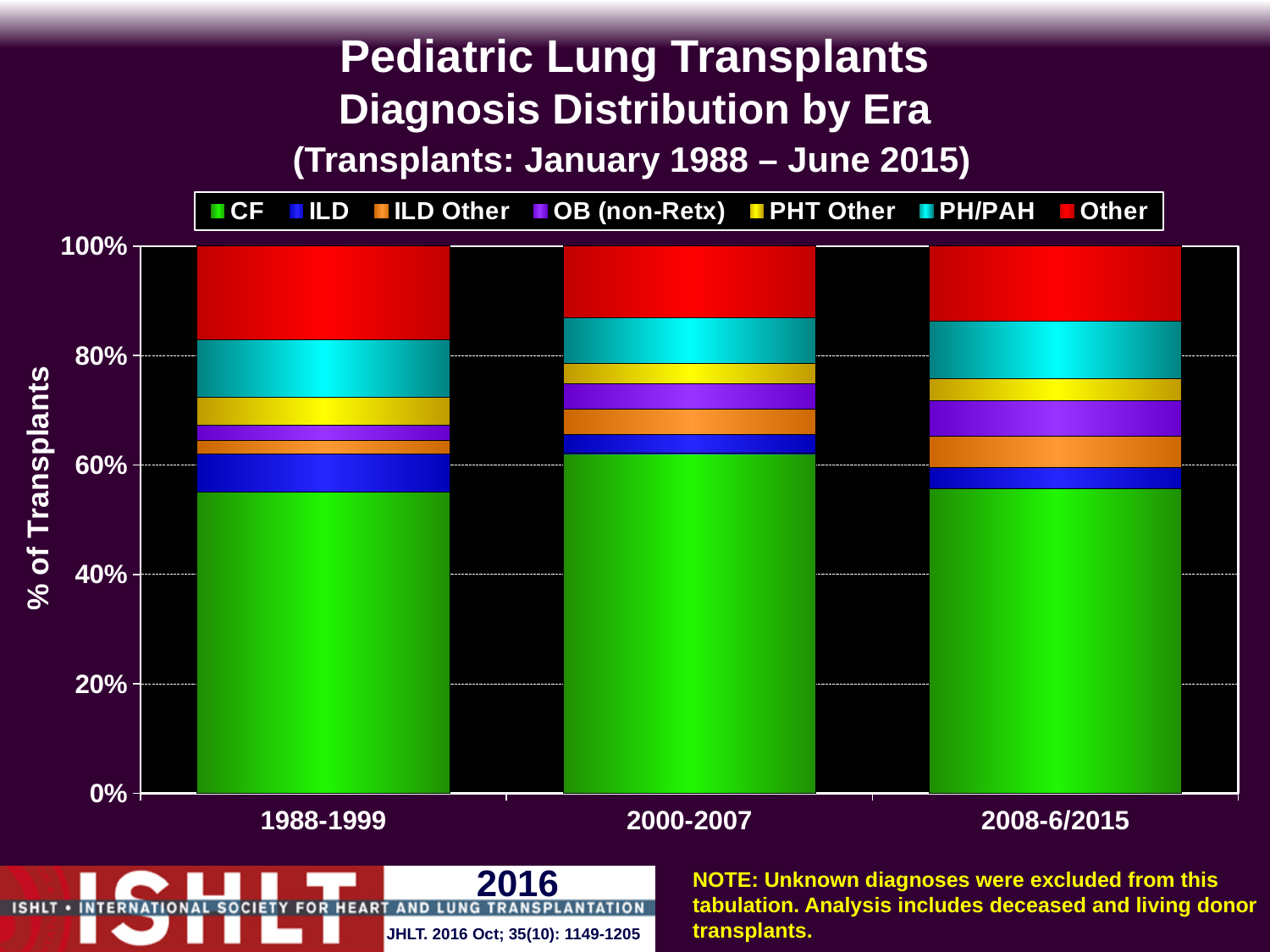
Is the CF share of transplants in the 1988-1999 era greater or less than 60%? less Which diagnosis is listed first in the legend? CF How many eras (categories) are shown on the x axis? 3 How many diagnosis series does the legend list? 7 Which era has a larger CF share of transplants, 1988-1999 or 2000-2007? 2000-2007 What kind of chart is shown on the slide? stacked bar chart What is the label on the y axis? % of Transplants Which era has the largest CF share of transplants? 2000-2007 Is the CF share of transplants in the 2008-6/2015 era greater or less than 80%? less Is the CF share of transplants in the 2000-2007 era greater or less than 40%? greater What does each stacked bar total? 100%